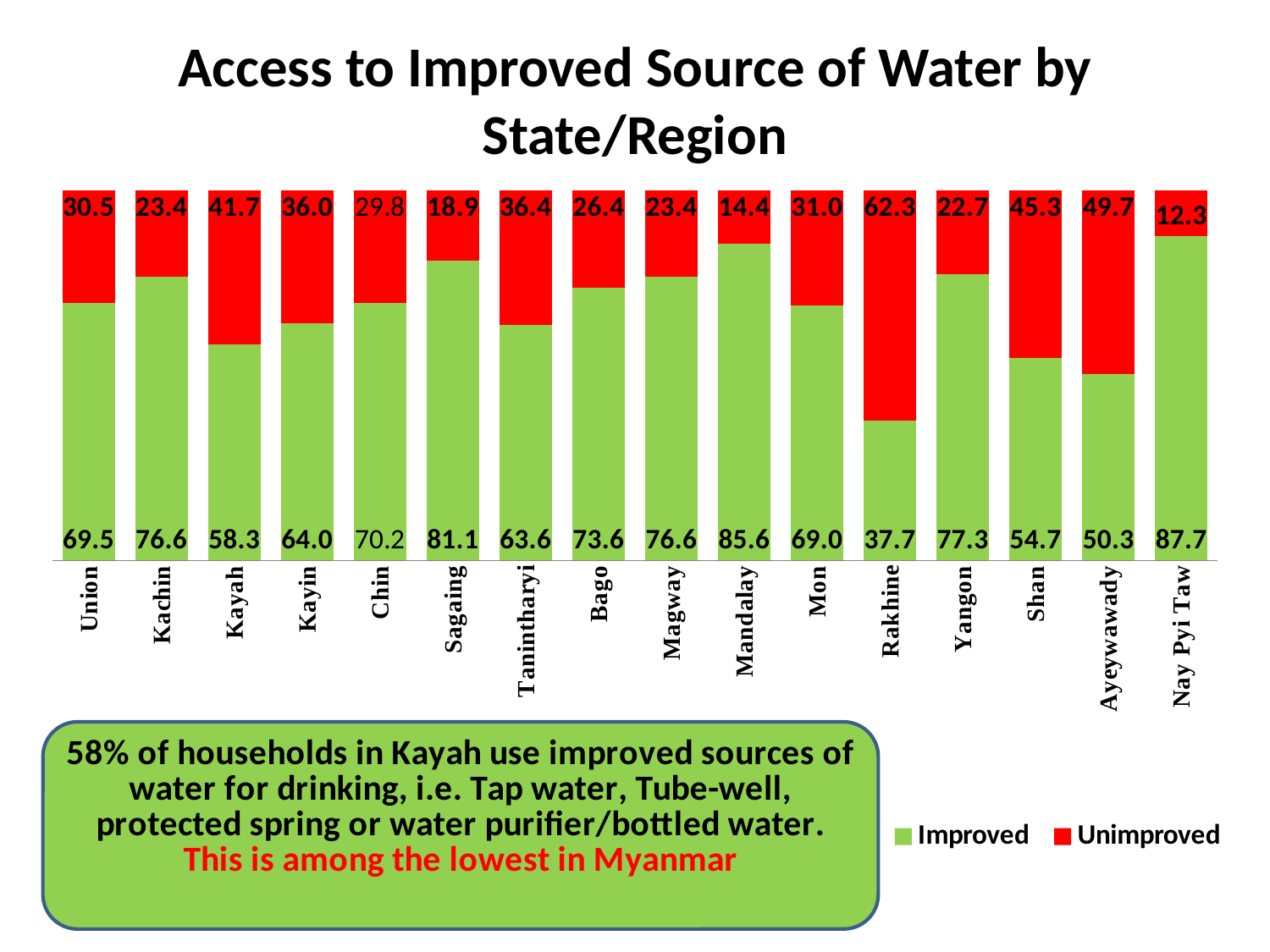
Which has a larger Unimproved value, Shan or Yangon? Shan Which state/region has the lowest Unimproved value? Nay Pyi Taw What is the Improved value for Kayah? 58.3 What is the difference between the Improved values for Nay Pyi Taw and Rakhine? 50.0 Which state/region has the highest Improved value? Nay Pyi Taw What is the total of the stacked bar for Union? 100.0 How many series does the legend list? 2 What is the Improved value for Mandalay? 85.6 What is the Unimproved value for Rakhine? 62.3 How many states/regions are shown on the x axis? 16 What kind of chart is shown on the slide? Stacked bar chart Which state/region has the lowest Improved value? Rakhine